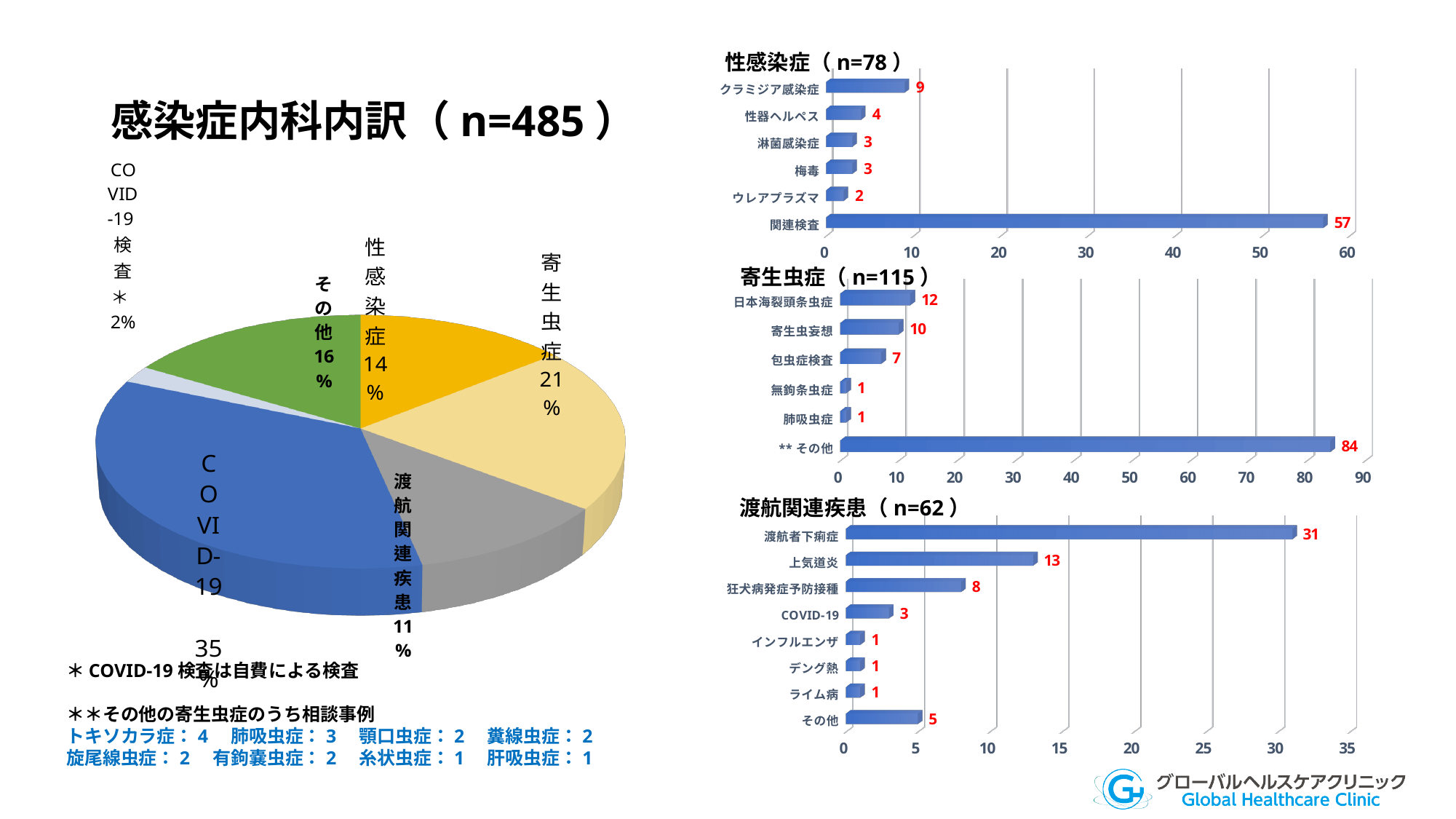
In the pie chart 感染症内科内訳（n=485）, which slice is the smallest? COVID-19検査 In the 渡航関連疾患（n=62） bar chart, what is the value for 渡航者下痢症? 31 In the 渡航関連疾患（n=62） bar chart, what is the difference between 上気道炎 and 狂犬病発症予防接種? 5 In the 性感染症（n=78） bar chart, which category has the highest value? 関連検査 In the 性感染症（n=78） bar chart, what is the value for クラミジア感染症? 9 What type of chart is the 渡航関連疾患（n=62） chart? bar chart In the 寄生虫症（n=115） bar chart, which is larger, 日本海裂頭条虫症 or 包虫症検査? 日本海裂頭条虫症 In the 渡航関連疾患（n=62） bar chart, how many categories are plotted? 8 In the pie chart 感染症内科内訳（n=485）, what share does COVID-19 have? 35% In the 寄生虫症（n=115） bar chart, what is the value for 寄生虫妄想? 10 In the 性感染症（n=78） bar chart, what is the difference between 関連検査 and クラミジア感染症? 48 In the 寄生虫症（n=115） bar chart, how many categories are plotted? 6